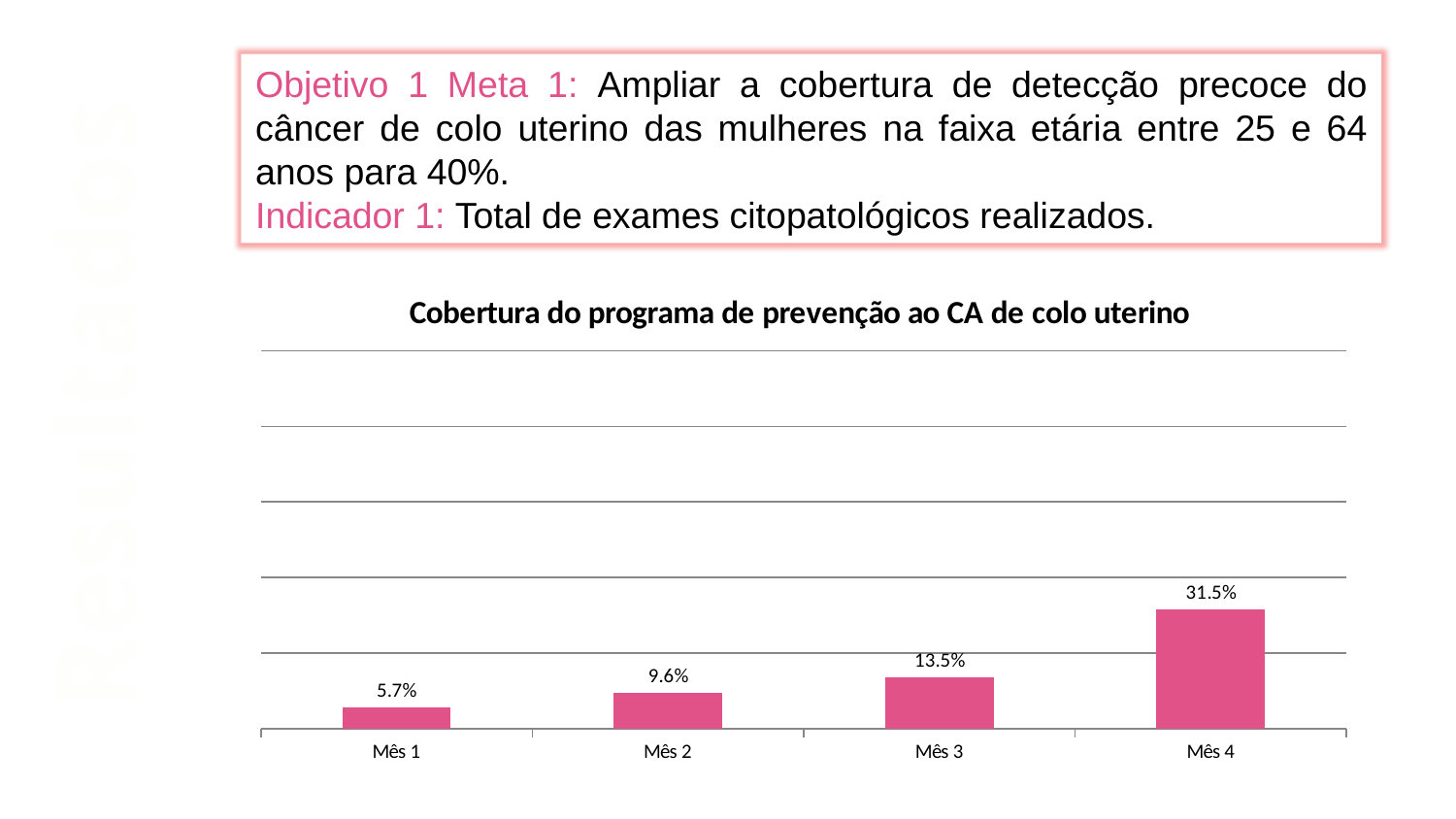
What is the difference between the values for Mês 4 and Mês 3? 18.0% What is the value for Mês 3? 13.5% Do the values rise or fall from Mês 1 to Mês 4? Rise Which month has the highest value? Mês 4 How many categories are shown on the x axis? 4 What is the value for Mês 4? 31.5% What is the value for Mês 1? 5.7% Which month has the lowest value? Mês 1 What kind of chart is this? Bar chart What is the title of the chart? Cobertura do programa de prevenção ao CA de colo uterino What is the difference between the values for Mês 2 and Mês 1? 3.9% Which is larger, the value for Mês 2 or the value for Mês 3? Mês 3